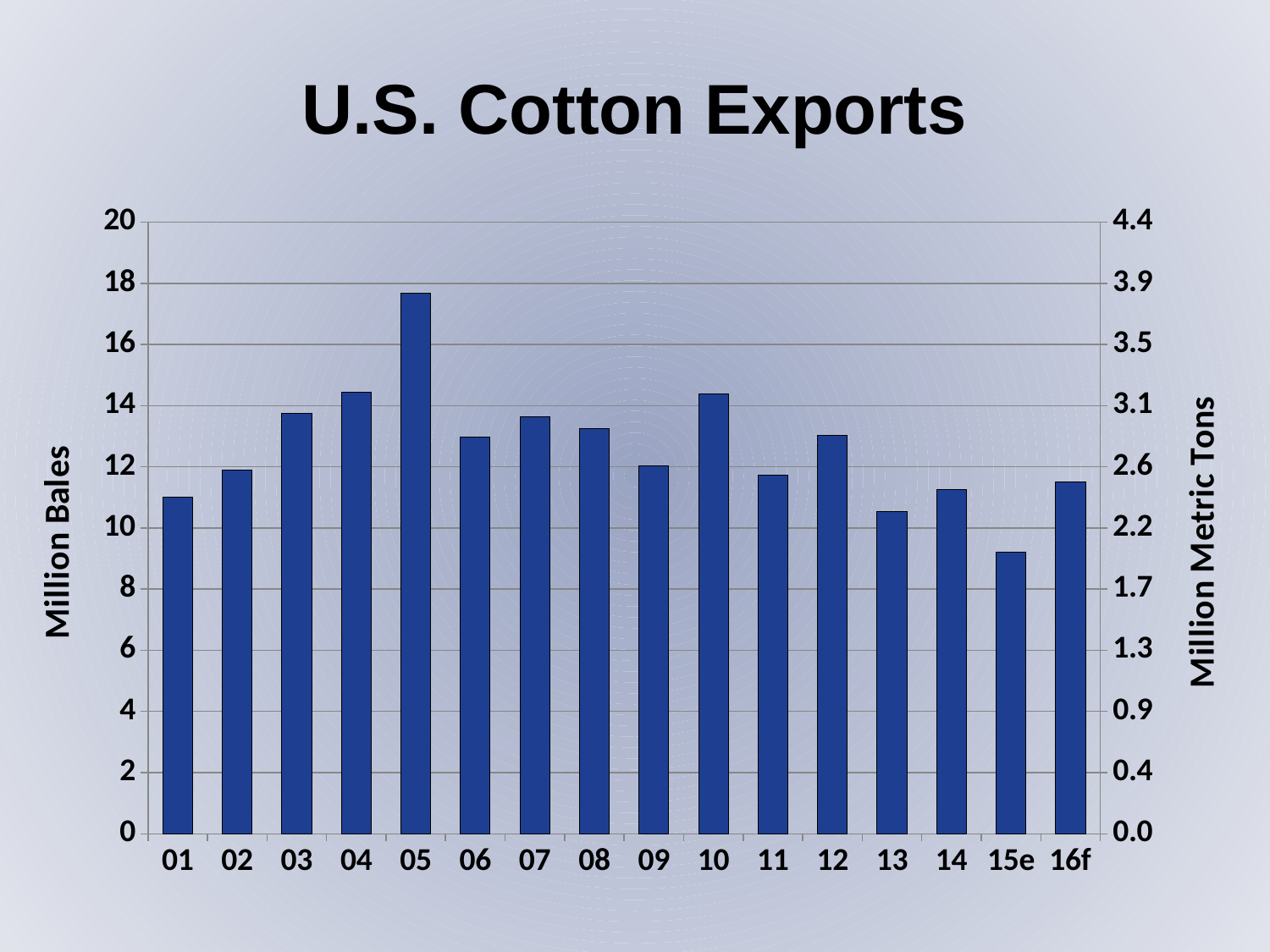
What kind of chart is shown on the slide? bar chart Is the value for 15e greater or less than 10 million bales? less Which year has the highest cotton exports? 05 Is the value for 01 greater or less than 10 million bales? greater Which year has the lowest cotton exports? 15e What is the label on the left vertical axis? Million Bales Is the value for 10 greater or less than 14 million bales? greater Which year has higher exports, 04 or 01? 04 How many years (bars) are shown on the x axis? 16 What is the title of the chart? U.S. Cotton Exports